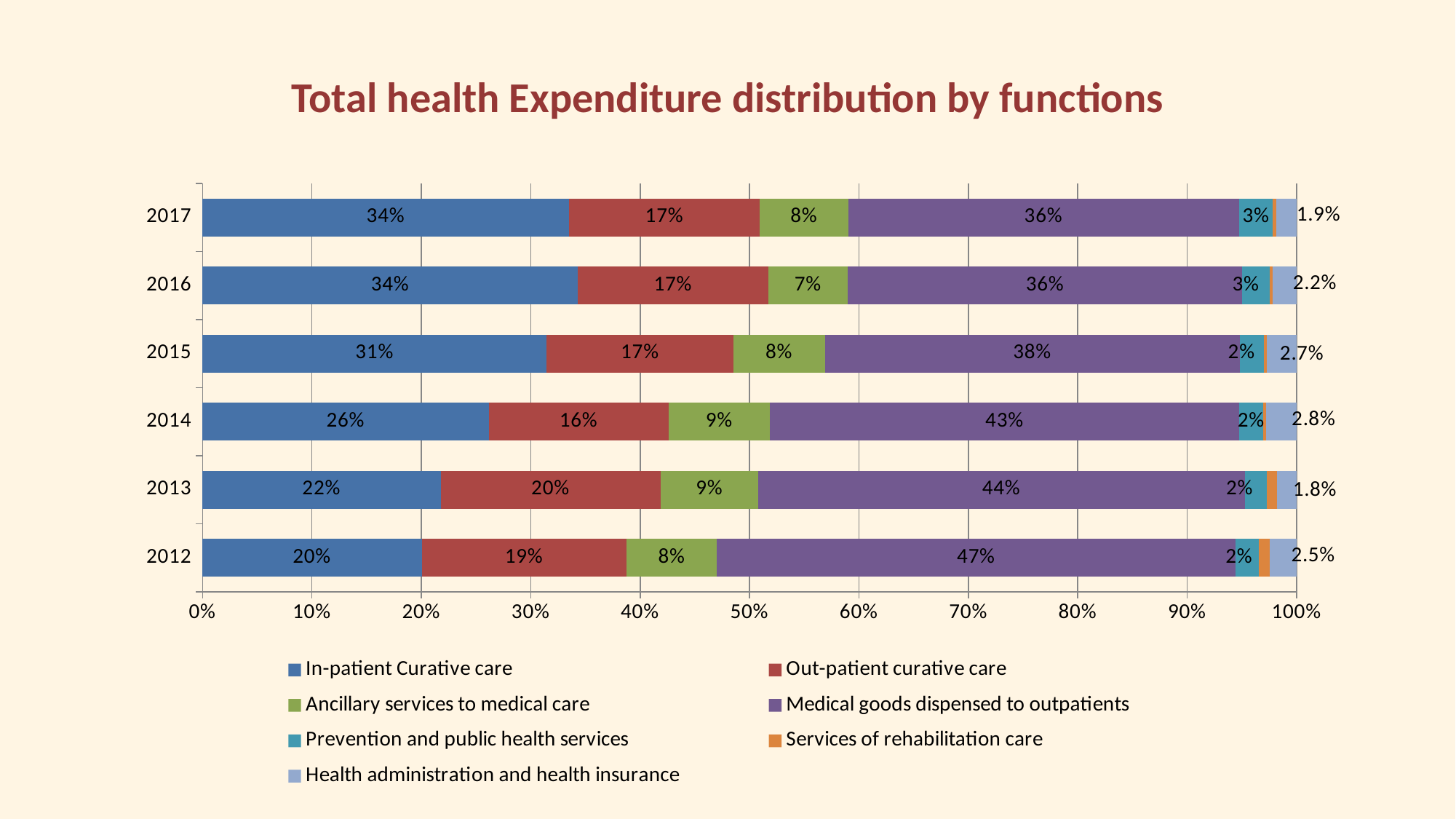
What is the difference between the In-patient Curative care share in 2017 and in 2012? 14% What is the share of Health administration and health insurance in 2014? 2.8% In which year is the share of Medical goods dispensed to outpatients highest? 2012 What kind of chart is shown on the slide? stacked bar chart How many years are shown on the chart? 6 What is the title of the chart? Total health Expenditure distribution by functions In which year is the share of In-patient Curative care lowest? 2012 Which is larger in 2013: the Out-patient curative care share or the Ancillary services to medical care share? Out-patient curative care How many series does the legend list? 7 What is the share of In-patient Curative care in 2015? 31% Does the share of In-patient Curative care rise or fall from 2012 to 2017? rise What is the share of Medical goods dispensed to outpatients in 2012? 47%